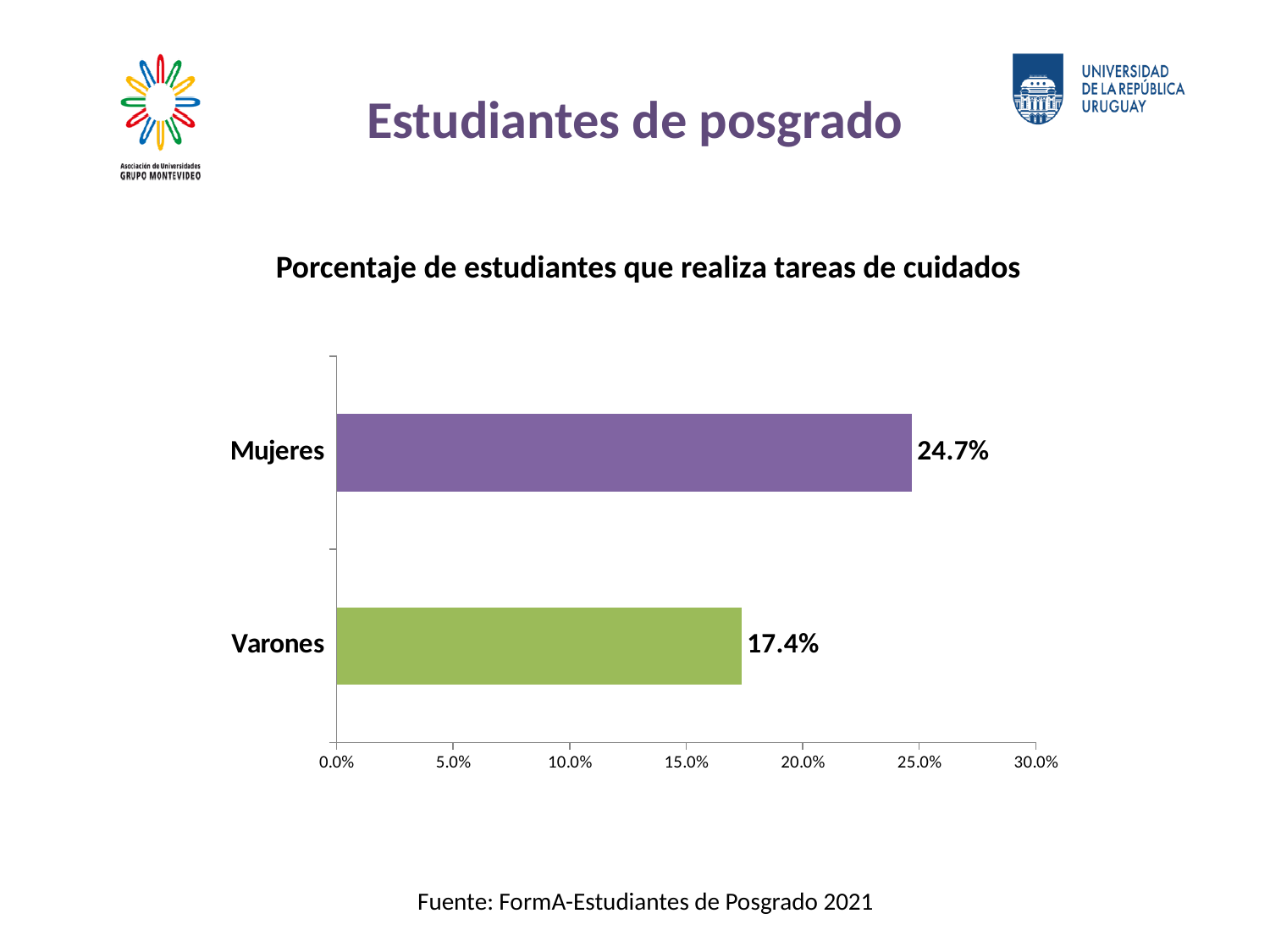
What is the difference between the values for Mujeres and Varones? 7.3% What kind of chart is shown on the slide? bar chart What colour is the bar for Varones? green How many categories are shown in the chart? 2 What is the value for Mujeres? 24.7% What is the title of the chart? Porcentaje de estudiantes que realiza tareas de cuidados Which category has the lowest value? Varones Is the value for Mujeres greater or less than 20.0%? greater Is the value for Varones greater or less than 20.0%? less Which is larger, the value for Mujeres or the value for Varones? Mujeres What is the value for Varones? 17.4% Which category has the highest value? Mujeres